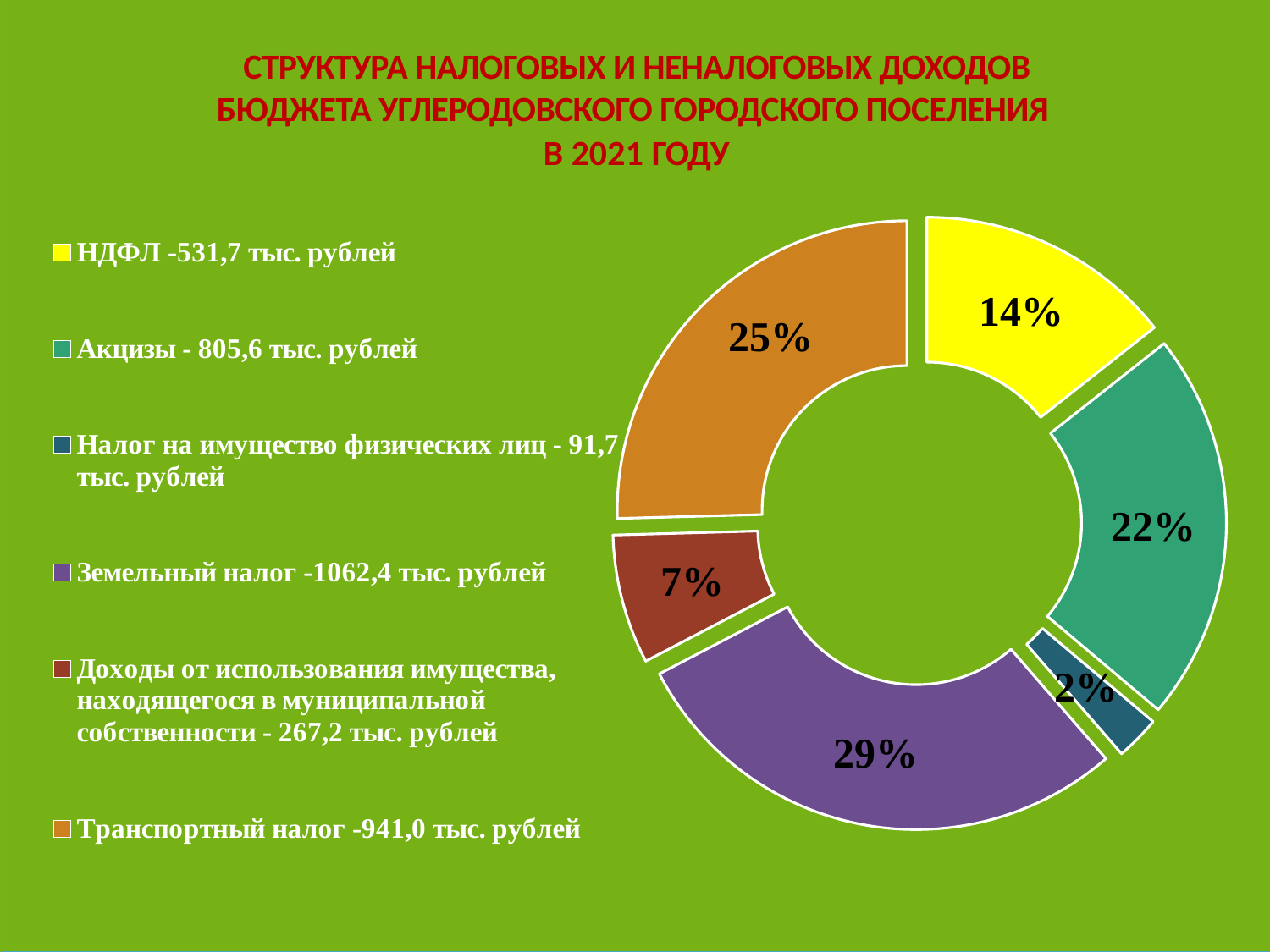
What share of the chart does Земельный налог account for? 29% What percentage is shown for the НДФЛ slice? 14% Which category has the largest share of the chart? Земельный налог According to the legend, what is the amount for Транспортный налог? 941,0 тыс. рублей How many categories are shown in the chart? 6 What is the difference in percentage points between the Земельный налог share and the Транспортный налог share? 4 percentage points Which has a larger share, Акцизы or НДФЛ? Акцизы What percentage is shown for Акцизы? 22% Which category has the smallest share of the chart? Налог на имущество физических лиц What colour is the slice for Земельный налог? Purple What share does Транспортный налог have in the chart? 25% What kind of chart is shown on the slide? Doughnut (pie) chart